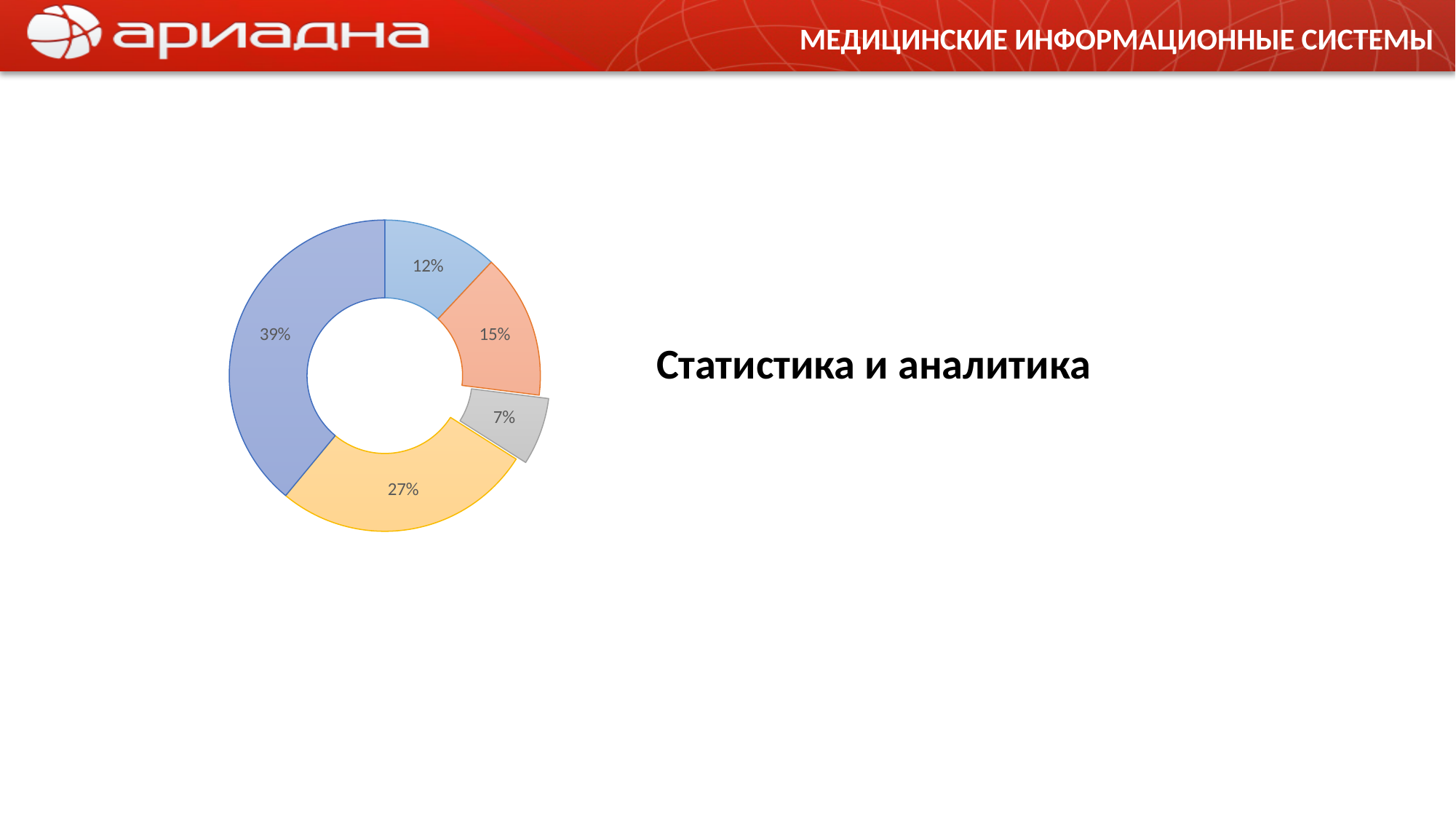
What is the difference in percentage points between the largest slice (39%) and the yellow slice (27%)? 12 Which slice is larger: the orange slice or the light blue slice? The orange slice (15%) What text appears to the right of the doughnut chart? Статистика и аналитика What percentage is shown on the light blue slice at the top of the doughnut chart? 12% What is the combined share of the grey and light blue slices? 19% How many slices does the doughnut chart have? 5 What percentage is shown on the yellow slice of the doughnut chart? 27% What kind of chart is shown on the slide? Doughnut chart What percentage is shown on the grey slice of the doughnut chart? 7% What percentage is shown on the orange slice of the doughnut chart? 15% What percentage is shown on the largest slice of the doughnut chart? 39% What percentage is shown on the smallest slice of the doughnut chart? 7%